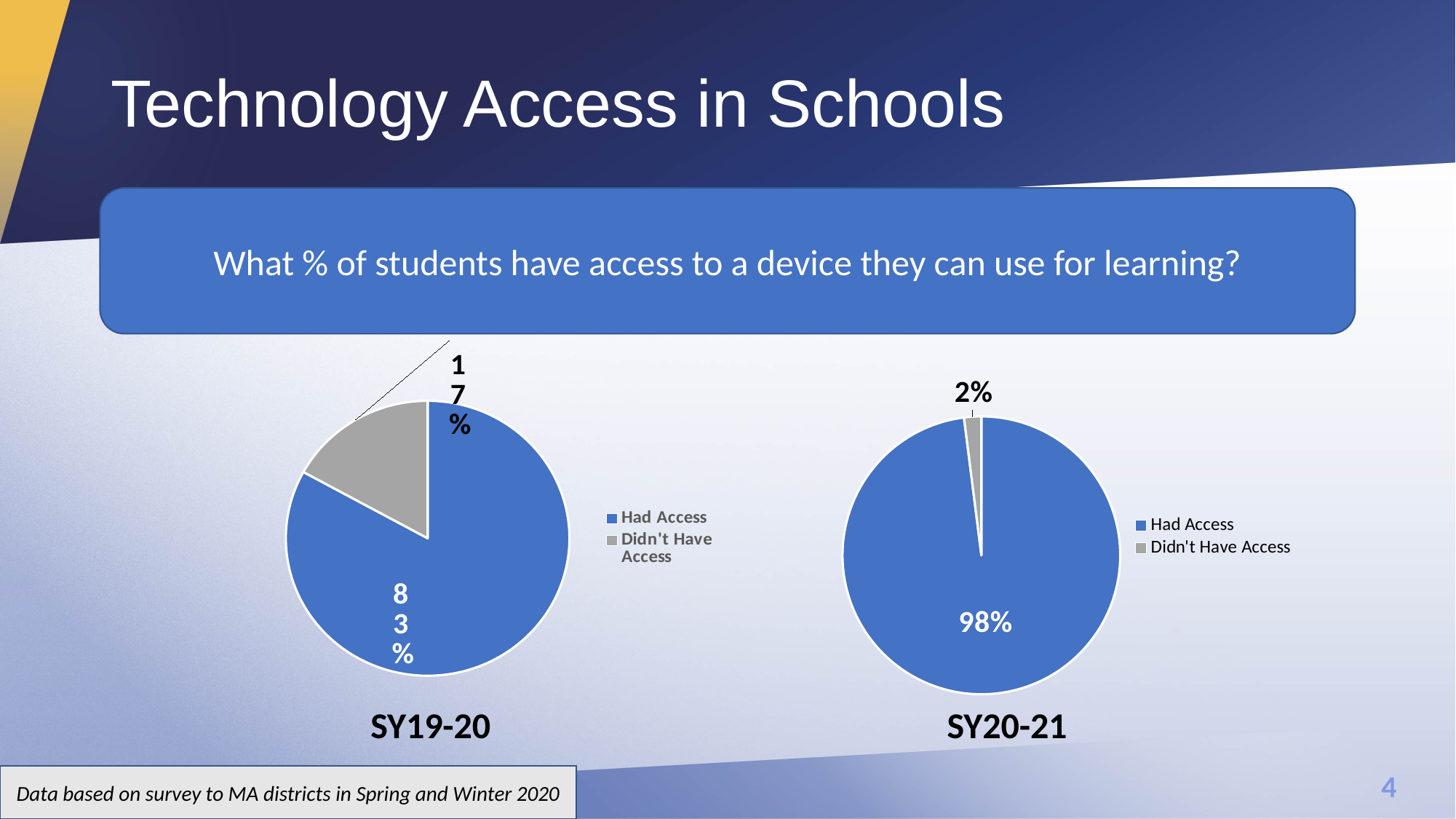
In the SY19-20 chart, which category is the smallest slice? Didn't Have Access How many entries does the legend of the SY19-20 chart list? 2 In the SY19-20 chart, what share of students had access? 83% In the SY20-21 chart, which category is the largest slice? Had Access How many slices does the SY20-21 pie chart have? 2 Which chart shows a larger Didn't Have Access share, SY19-20 or SY20-21? SY19-20 In the SY19-20 chart, what share of students didn't have access? 17% In the SY20-21 chart, what share of students had access? 98% In the SY20-21 chart, what colour is the Didn't Have Access slice? Gray What is the difference between the Had Access share in the SY20-21 chart and the Had Access share in the SY19-20 chart? 15% What kind of chart is the SY19-20 chart? Pie chart In the SY20-21 chart, what share of students didn't have access? 2%